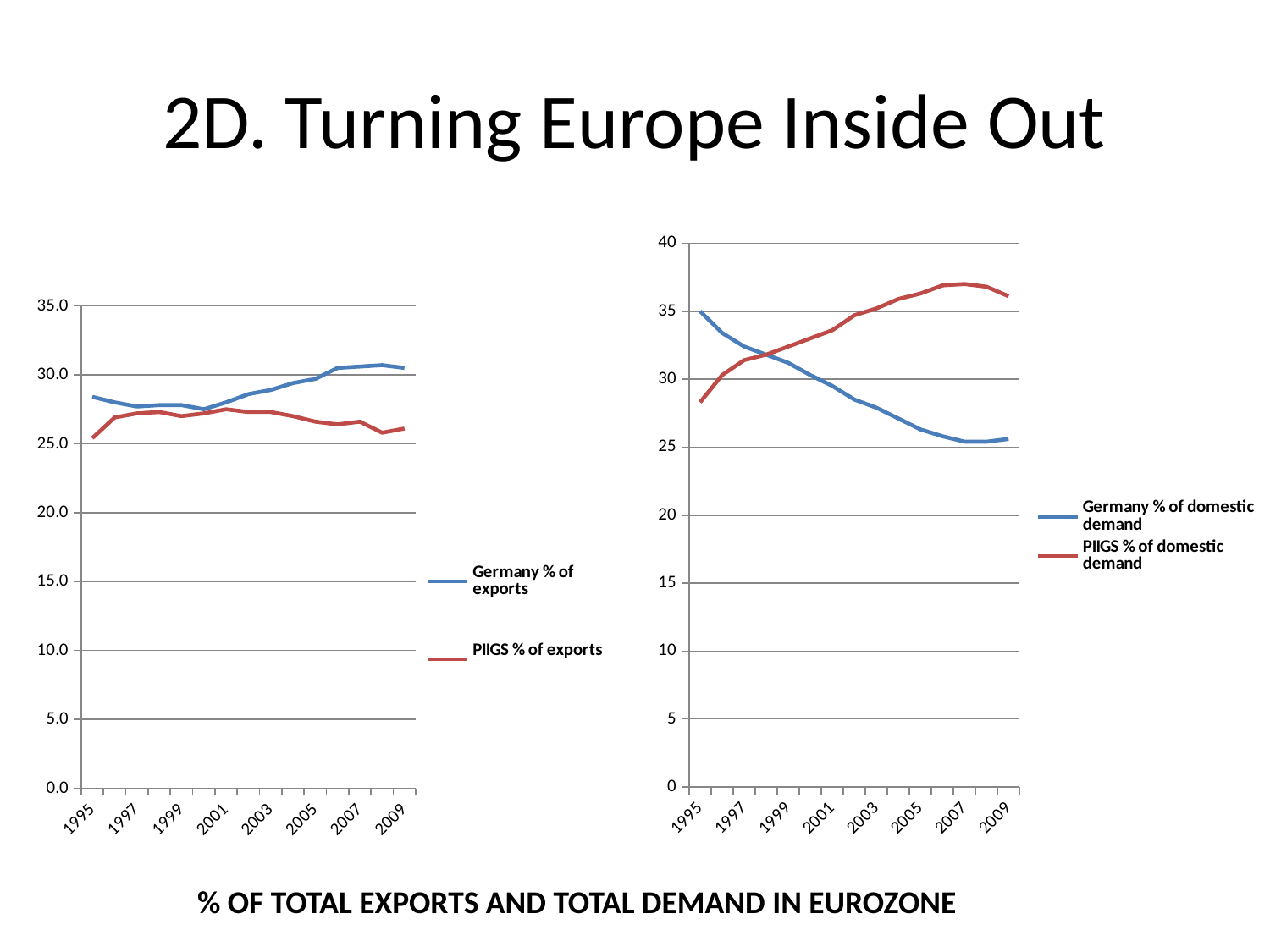
What kind of chart is the chart on the left of the slide? line chart In the chart on the right, is the value for Germany % of domestic demand in 2009 greater or less than 30? less How many series does the legend of the chart on the right list? 2 In the chart on the left, is the value for Germany % of exports in 2007 greater or less than 30.0? greater In the chart on the right, does the Germany % of domestic demand line rise or fall from 1995 to 2009? fall In the chart on the right, which series has the larger value in 1995, Germany % of domestic demand or PIIGS % of domestic demand? Germany % of domestic demand In the chart on the right, which series has the larger value in 2009, Germany % of domestic demand or PIIGS % of domestic demand? PIIGS % of domestic demand In the chart on the right, does the PIIGS % of domestic demand line rise or fall from 1995 to 2009? rise What is the caption printed below the two charts? % OF TOTAL EXPORTS AND TOTAL DEMAND IN EUROZONE In the chart on the left, does the Germany % of exports line rise or fall overall from 1995 to 2009? rise In the chart on the left, which series has the larger value in 2009, Germany % of exports or PIIGS % of exports? Germany % of exports In the chart on the right, is the value for PIIGS % of domestic demand in 1995 greater or less than 30? less